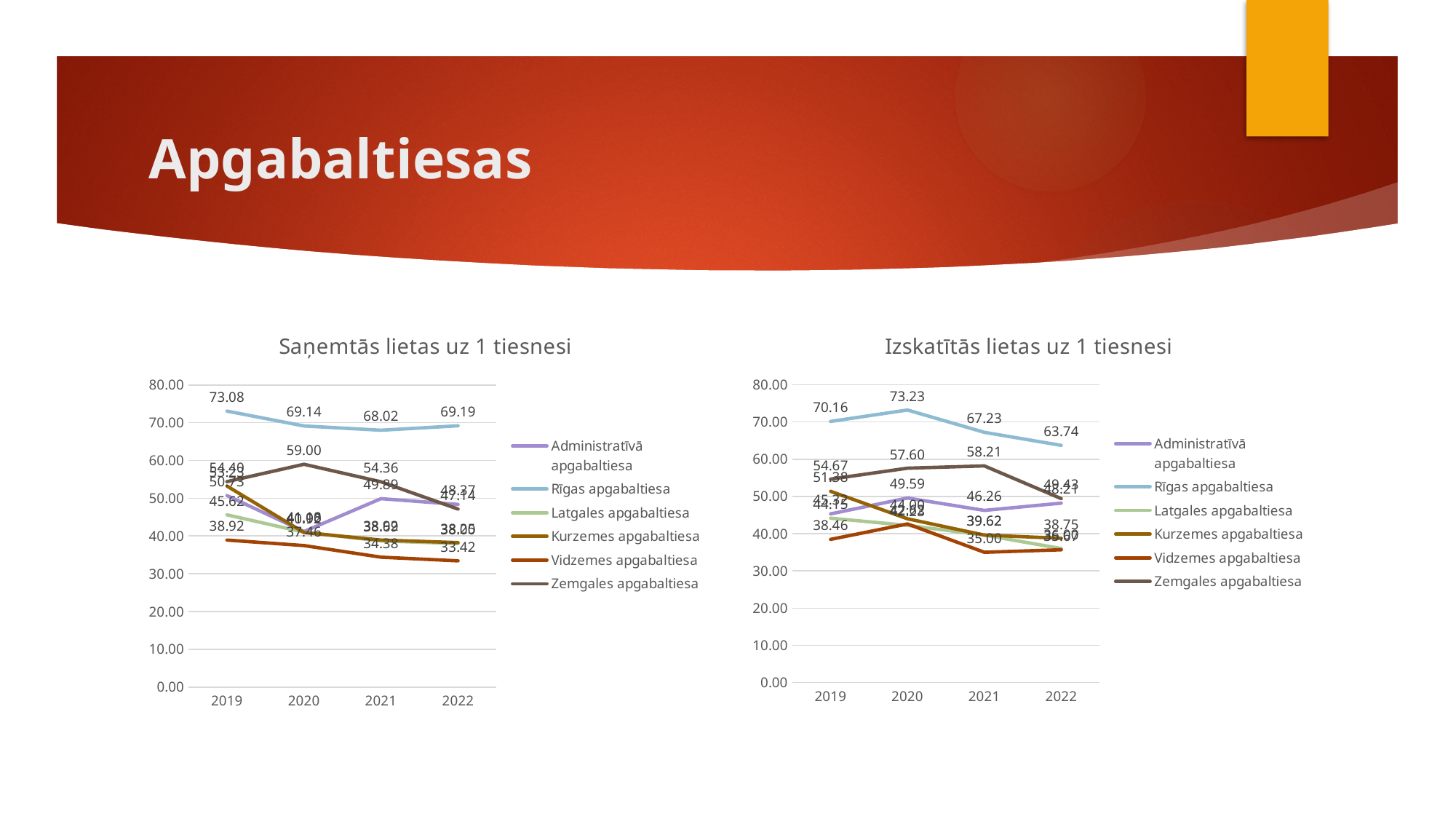
In the chart titled 'Izskatītās lietas uz 1 tiesnesi', which is larger for Rīgas apgabaltiesa: the 2021 value or the 2022 value? 2021 What kind of chart is the chart titled 'Saņemtās lietas uz 1 tiesnesi'? line chart In the chart titled 'Saņemtās lietas uz 1 tiesnesi', do the values for Vidzemes apgabaltiesa rise or fall from 2019 to 2022? fall In the chart titled 'Saņemtās lietas uz 1 tiesnesi', is the value for Vidzemes apgabaltiesa in 2021 greater or less than 40.00? less In the chart titled 'Saņemtās lietas uz 1 tiesnesi', what is the value for Rīgas apgabaltiesa in 2019? 73.08 In the chart titled 'Saņemtās lietas uz 1 tiesnesi', in which year is the value for Rīgas apgabaltiesa lowest? 2021 In the chart titled 'Saņemtās lietas uz 1 tiesnesi', what is the value for Zemgales apgabaltiesa in 2020? 59.00 In the chart titled 'Izskatītās lietas uz 1 tiesnesi', in which year is the value for Rīgas apgabaltiesa highest? 2020 In the chart titled 'Izskatītās lietas uz 1 tiesnesi', what is the value for Rīgas apgabaltiesa in 2020? 73.23 In the chart titled 'Saņemtās lietas uz 1 tiesnesi', what is the value for Vidzemes apgabaltiesa in 2022? 33.42 How many series does the legend of the chart titled 'Izskatītās lietas uz 1 tiesnesi' list? 6 In the chart titled 'Izskatītās lietas uz 1 tiesnesi', what is the difference between the Rīgas apgabaltiesa values for 2019 and 2022? 6.42